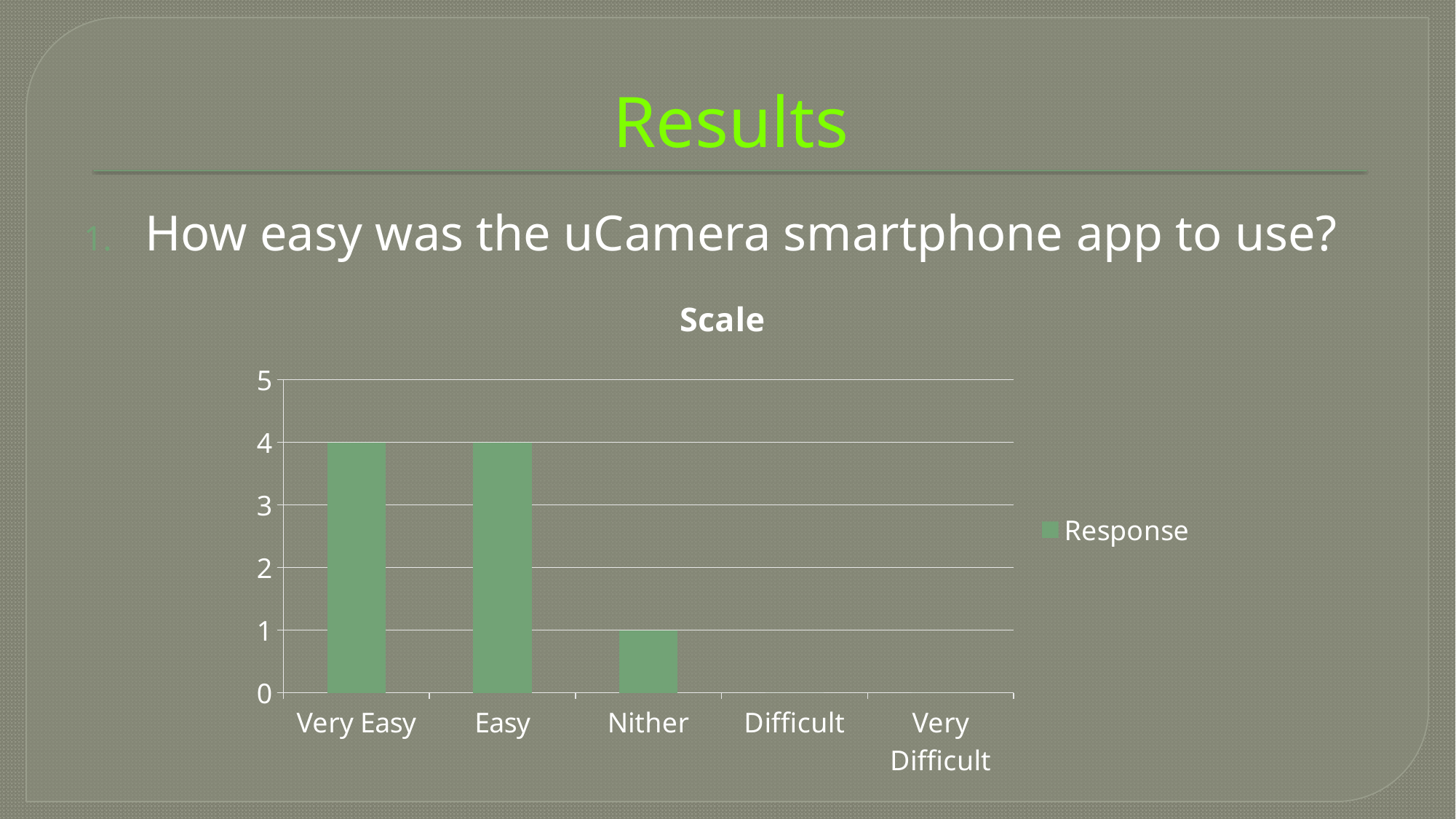
What is the difference between the value for Very Easy and the value for Nither? 3 What is the value for Easy? 4 How many categories are shown on the x axis? 5 What is the value for Nither? 1 How many series does the legend list? 1 What kind of chart is shown? bar chart What is the value for Very Easy? 4 Is the value for Nither greater or less than 2? less What is the value for Very Difficult? 0 What is the value for Difficult? 0 What is the title of the chart? Scale Which is larger, the value for Easy or the value for Nither? Easy